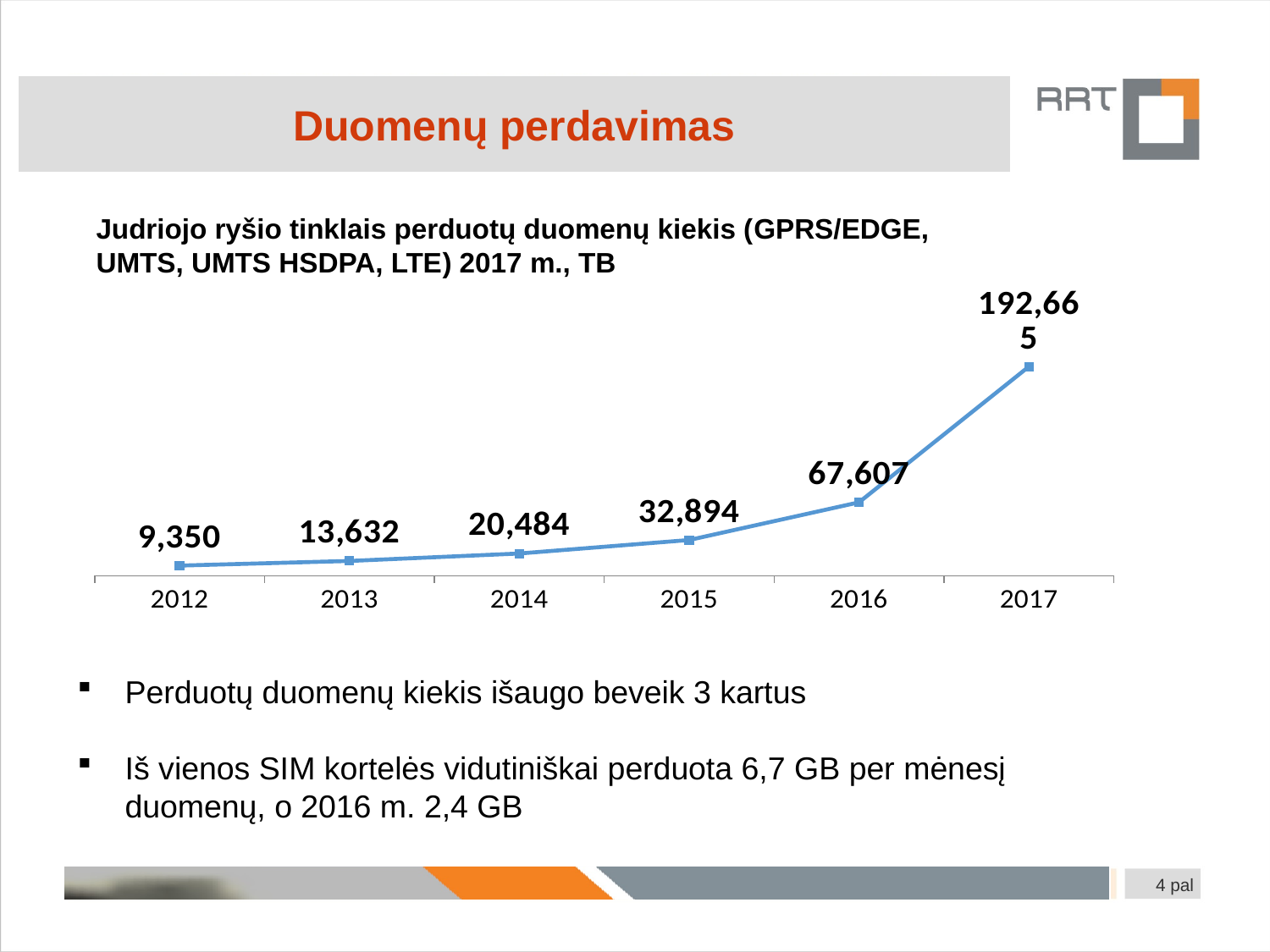
What type of chart is shown on the slide? line chart What is the value for 2014? 20,484 What is the difference between the values for 2017 and 2016? 125,058 What is the value for 2017? 192,665 What is the difference between the values for 2013 and 2012? 4,282 How many years are plotted on the x axis? 6 Which is larger, the value for 2015 or the value for 2014? 2015 What is the value for 2012? 9,350 Do the values rise or fall from 2012 to 2017? rise Which year has the highest value? 2017 What is the value for 2016? 67,607 Which year has the lowest value? 2012